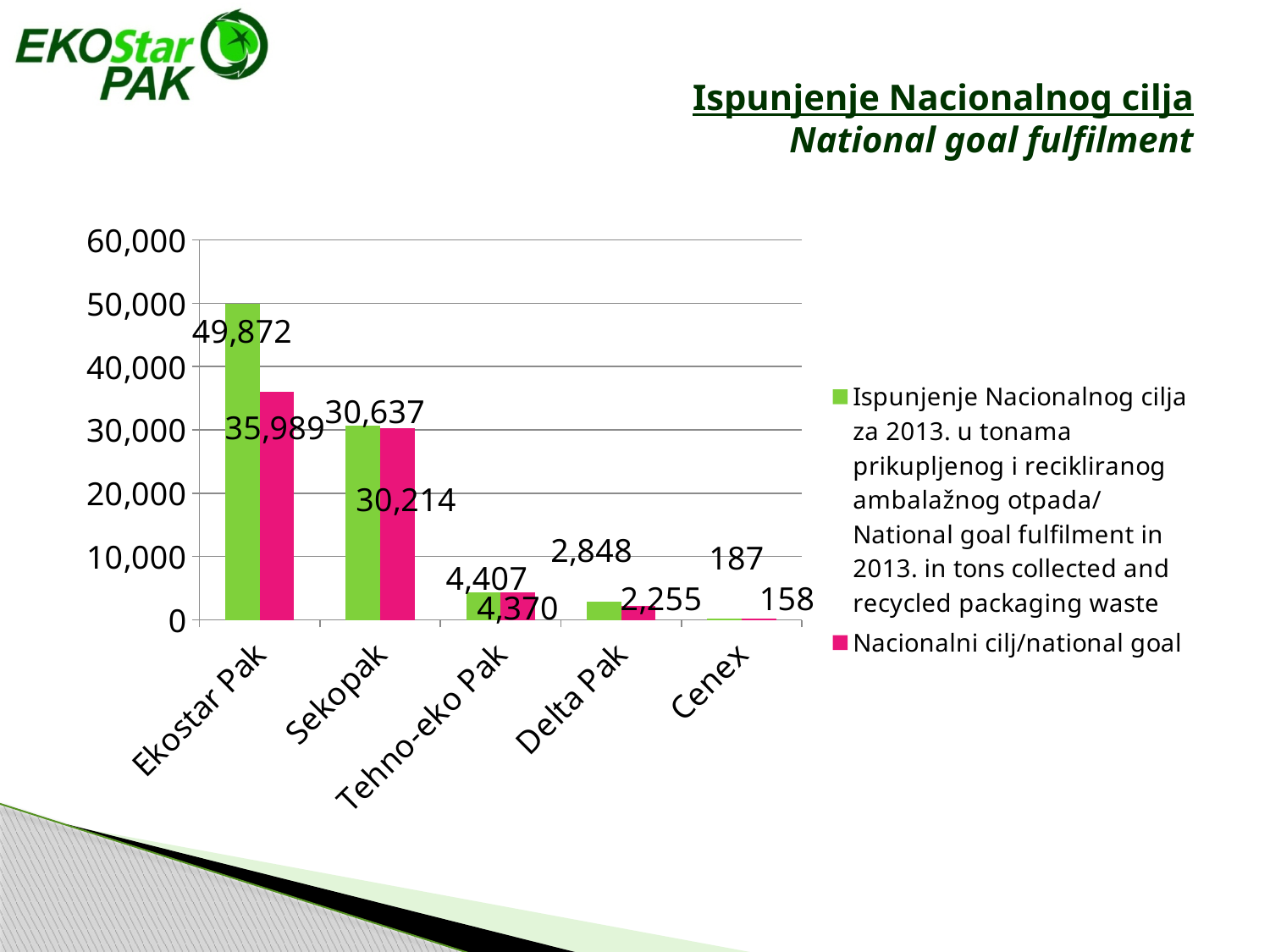
How many series does the chart legend list? 2 What is the national goal (pink bar) for Delta Pak? 2,255 What is the national goal fulfilment value (green bar) for Sekopak? 30,637 What is the national goal (pink bar) for Cenex? 158 Which company has the highest national goal fulfilment value (green bar)? Ekostar Pak What is the national goal (pink bar) for Ekostar Pak? 35,989 What is the national goal fulfilment value (green bar) for Ekostar Pak? 49,872 What is the difference between the fulfilment value and the national goal for Ekostar Pak? 13,883 Which is larger for Delta Pak: the fulfilment value (green) or the national goal (pink)? Fulfilment value (green), 2,848 Which company has the lowest national goal (pink bar)? Cenex How many companies are shown on the x axis of the chart? 5 Is the national goal fulfilment value for Sekopak greater or less than 40,000? less